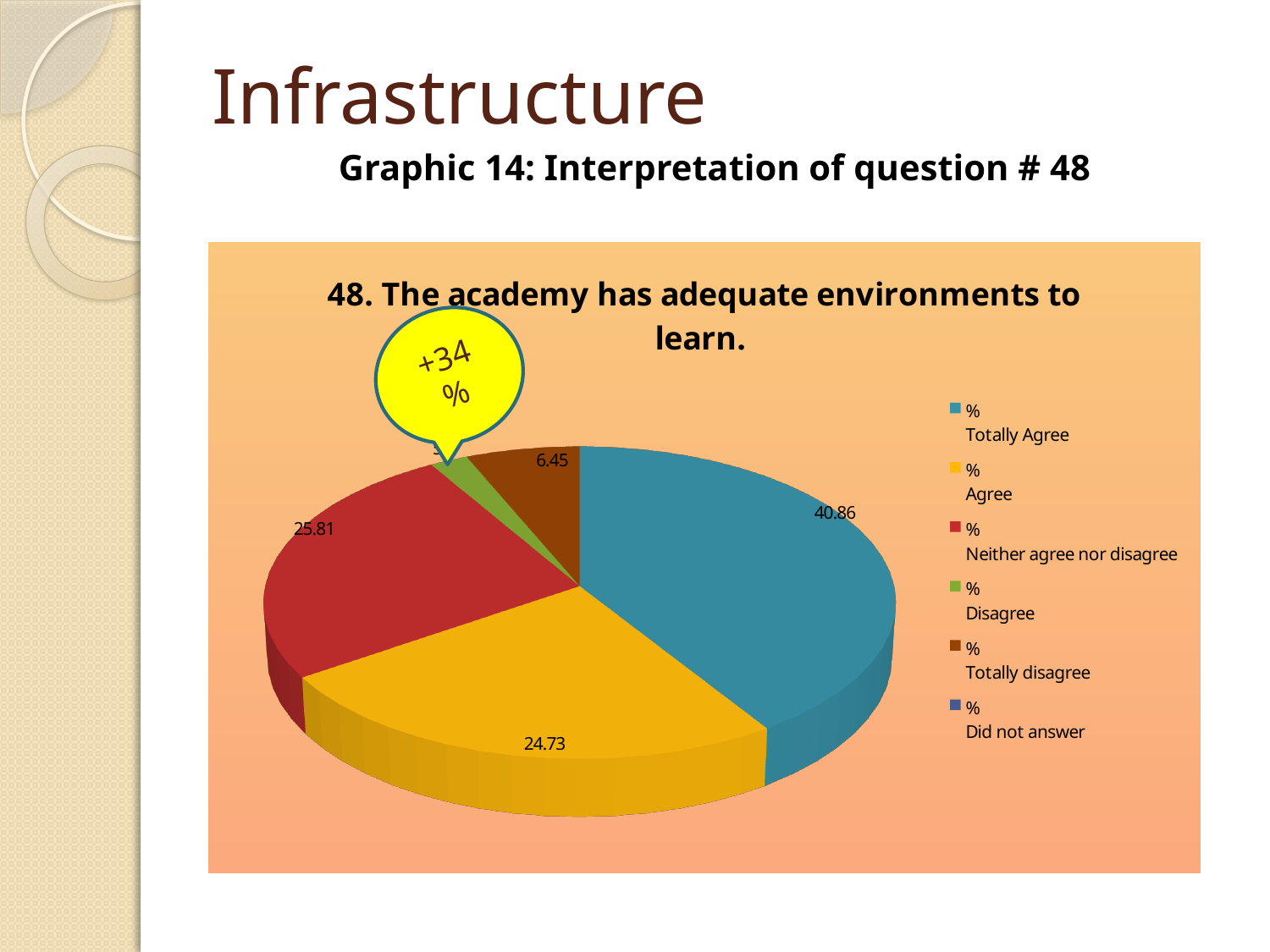
What text is written in the yellow callout bubble on the chart? +34 % Which is larger, the Agree slice or the Neither agree nor disagree slice? Neither agree nor disagree What is the value shown for the Totally disagree slice? 6.45 What is the value shown for the Neither agree nor disagree slice? 25.81 What is the value shown for the Totally Agree slice? 40.86 How many entries does the chart legend list? 6 Which response category has the largest slice of the pie? Totally Agree What is the title of the chart? 48. The academy has adequate environments to learn. What type of chart is shown on the slide? Pie chart What is the value shown for the Agree slice? 24.73 What is the difference between the Totally Agree value and the Agree value? 16.13 What is the difference between the Totally Agree value and the Totally disagree value? 34.41